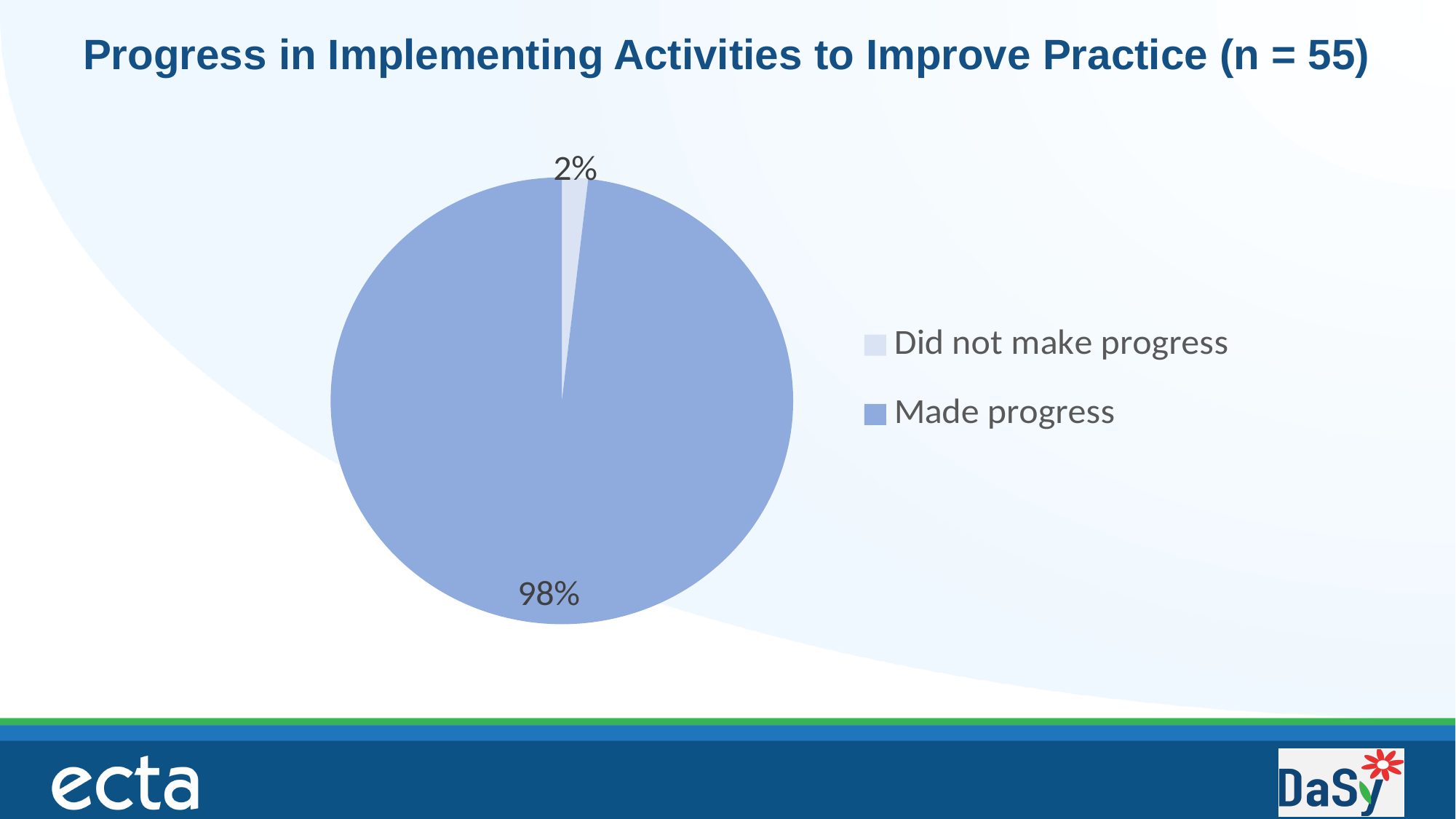
What share of the pie does the 'Made progress' slice represent? 98% Which is larger: the share for 'Made progress' or for 'Did not make progress'? Made progress What kind of chart is shown on the slide? Pie chart Which category has the largest share of the pie? Made progress How many categories does the pie chart show? 2 Which category has the smallest share of the pie? Did not make progress What is the difference in percentage points between 'Made progress' and 'Did not make progress'? 96 What is the sample size (n) stated in the chart title? 55 What is the title of the chart? Progress in Implementing Activities to Improve Practice (n = 55) How many entries does the legend list? 2 What percentage of respondents made progress? 98% What percentage of respondents did not make progress? 2%